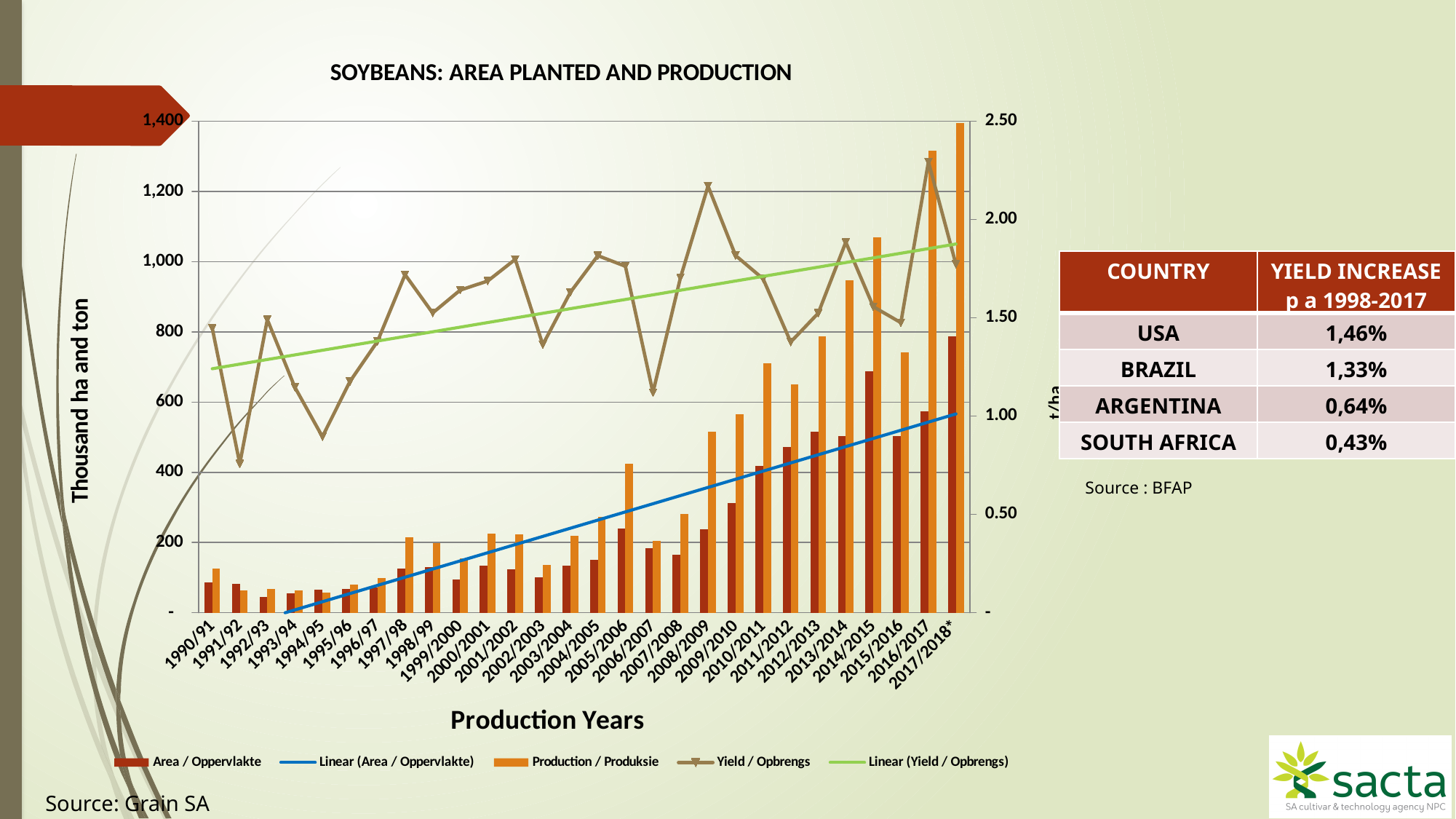
Is the Production / Produksie value for 2017/2018* greater or less than 1,200? greater How many production years are shown on the x axis of the chart? 28 In which production year is the Area / Oppervlakte bar highest? 2017/2018* In which production year is the Yield / Opbrengs line at its lowest point? 1991/92 Do the Area / Oppervlakte bars generally rise or fall from 1990/91 to 2017/2018*? rise What is the title of the x axis of the chart? Production Years How many series does the chart legend list? 5 In which production year is the Production / Produksie bar highest? 2017/2018* Is the Yield / Opbrengs value for 1991/92 greater or less than 1.00? less What kind of chart is shown on the slide? A combined bar and line chart Which is larger in 2017/2018*, the Area / Oppervlakte bar or the Production / Produksie bar? Production / Produksie Is the Yield / Opbrengs value for 2008/2009 greater or less than 2.00? greater